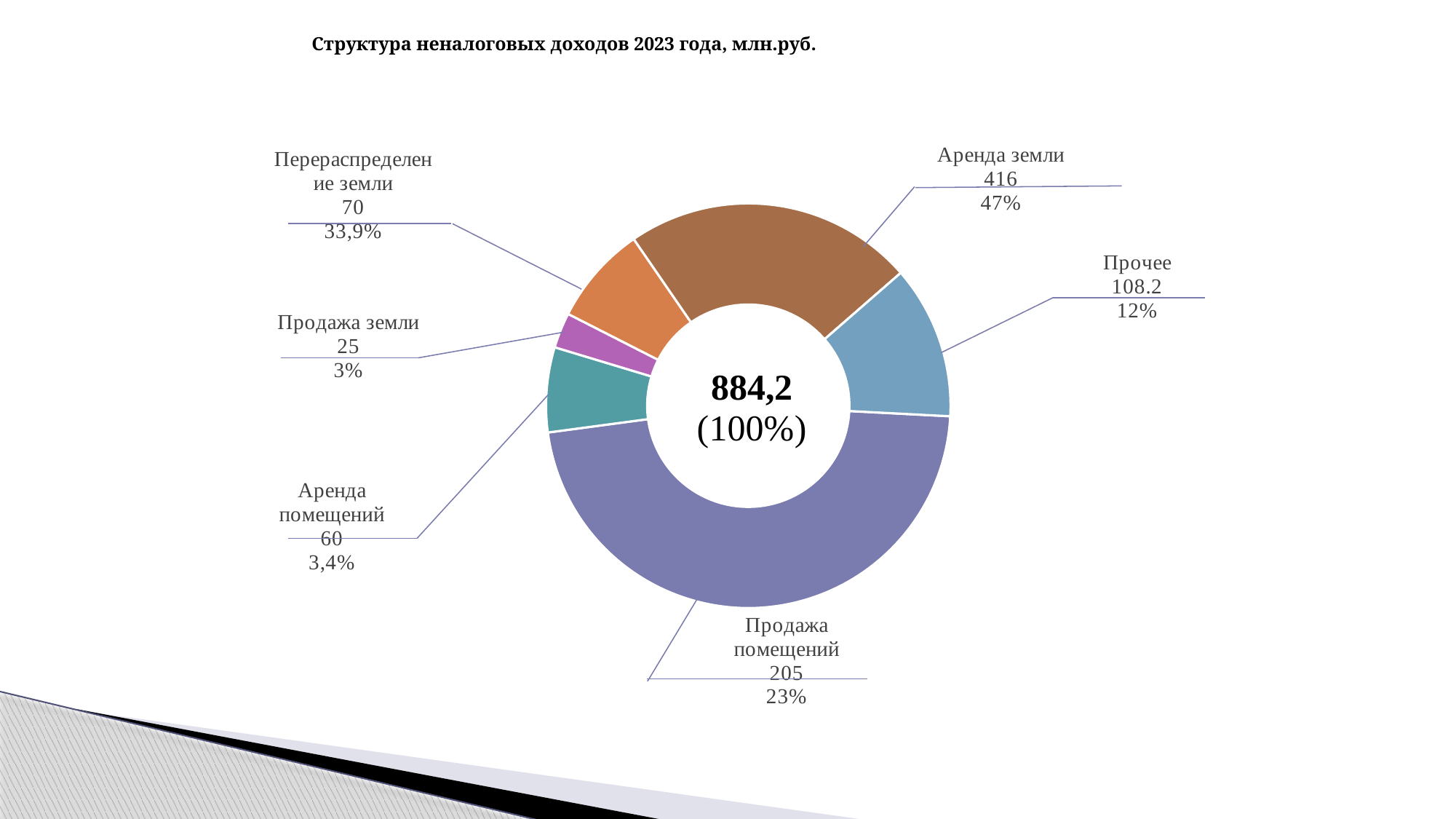
What is the value for Продажа помещений? 205 What share of the total does Аренда земли account for, as printed on the chart? 47% What is the title of the chart? Структура неналоговых доходов 2023 года, млн.руб. Which is larger, the value for Прочее or the value for Перераспределение земли? Прочее How many categories does the chart show? 6 What is the value for Прочее? 108.2 Which category has the lowest value? Продажа земли What is the value for Аренда земли? 416 What kind of chart is shown on the slide? pie chart (doughnut) What is the difference between the values for Аренда земли and Продажа помещений? 211 Which category has the highest value? Аренда земли What total value is printed in the centre of the chart? 884,2